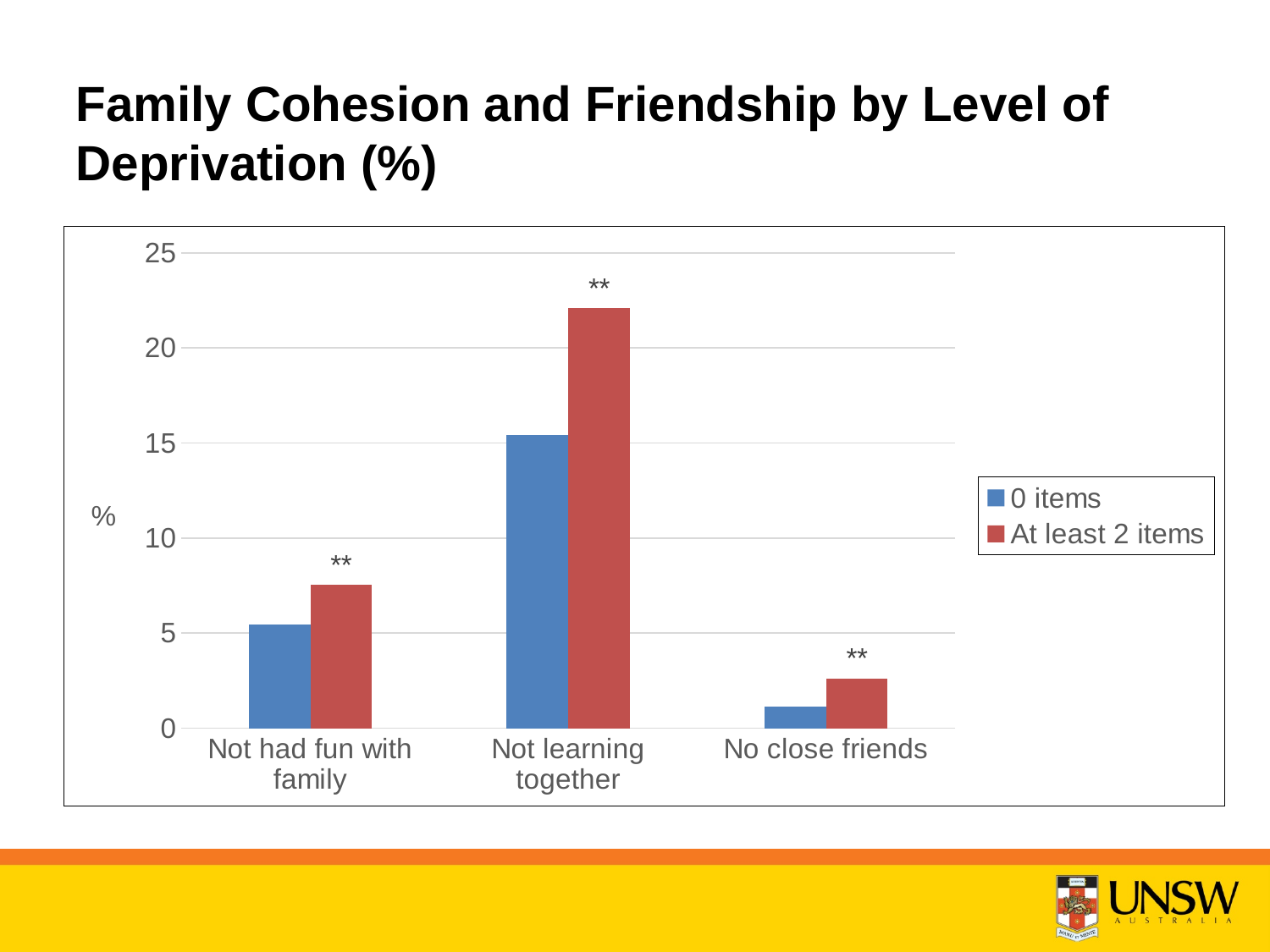
Is the value for 'At least 2 items' in 'Not learning together' greater or less than 20? greater Is the value for '0 items' in 'Not learning together' greater or less than 10? greater Which series is shown in red? At least 2 items How many series does the legend list? 2 Is the value for 'At least 2 items' in 'No close friends' greater or less than 5? less Which category has the lowest value for the '0 items' series? No close friends How many categories are shown on the x axis? 3 What is the label on the y axis? % What kind of chart is shown on the slide? bar chart For 'Not learning together', which series has the larger value: '0 items' or 'At least 2 items'? At least 2 items Which category has the highest value for the 'At least 2 items' series? Not learning together